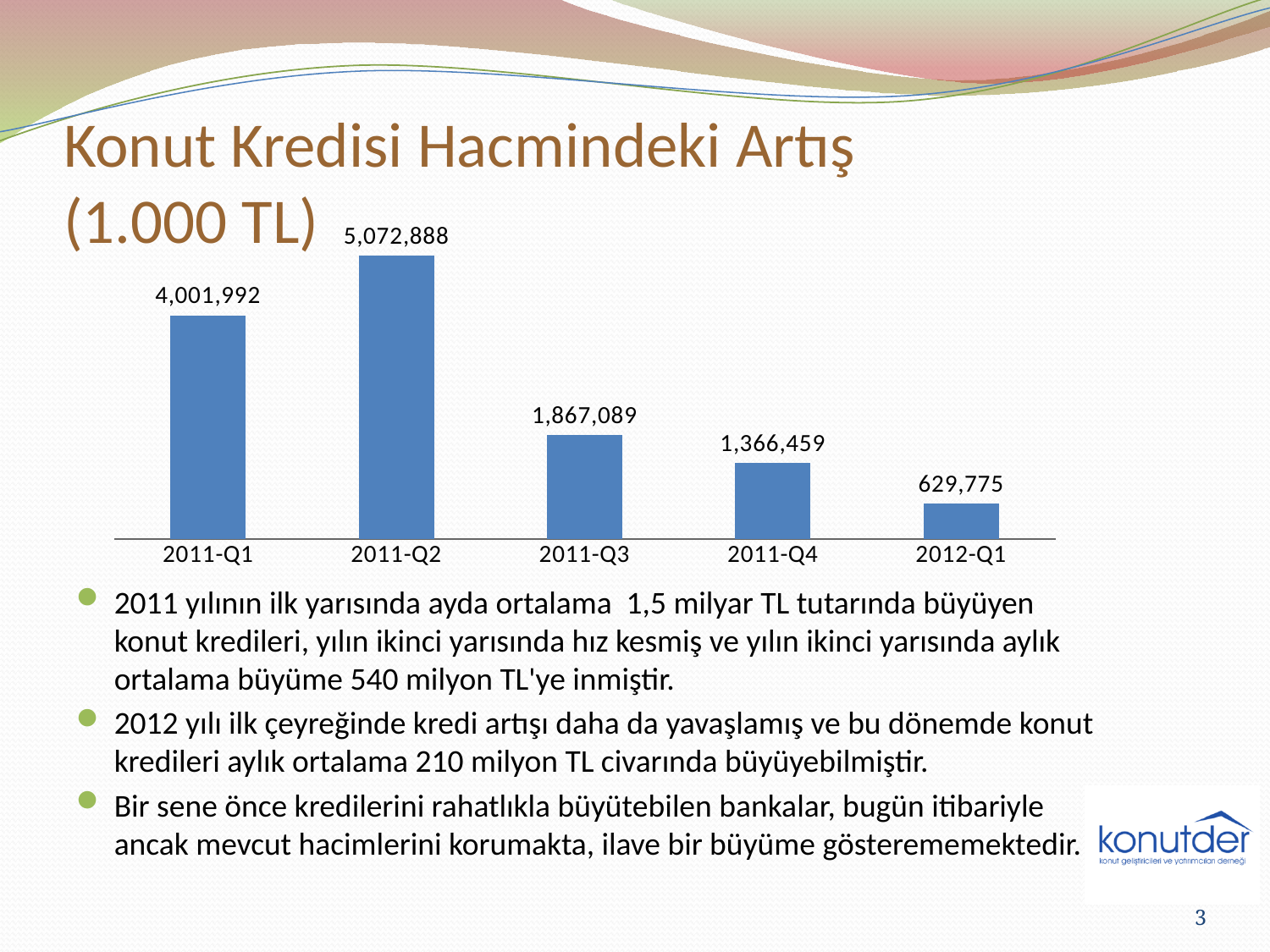
Which is larger, the value for 2011-Q3 or the value for 2011-Q4? 2011-Q3 Which quarter has the lowest value? 2012-Q1 How many quarters are shown in the chart? 5 What is the value for 2011-Q2? 5,072,888 What kind of chart is shown on the slide? Bar chart What is the value for 2011-Q1? 4,001,992 What is the value for 2012-Q1? 629,775 What is the value for 2011-Q4? 1,366,459 What is the difference between the values for 2011-Q4 and 2012-Q1? 736,684 Which quarter has the highest value? 2011-Q2 What is the difference between the values for 2011-Q2 and 2011-Q1? 1,070,896 What is the value for 2011-Q3? 1,867,089